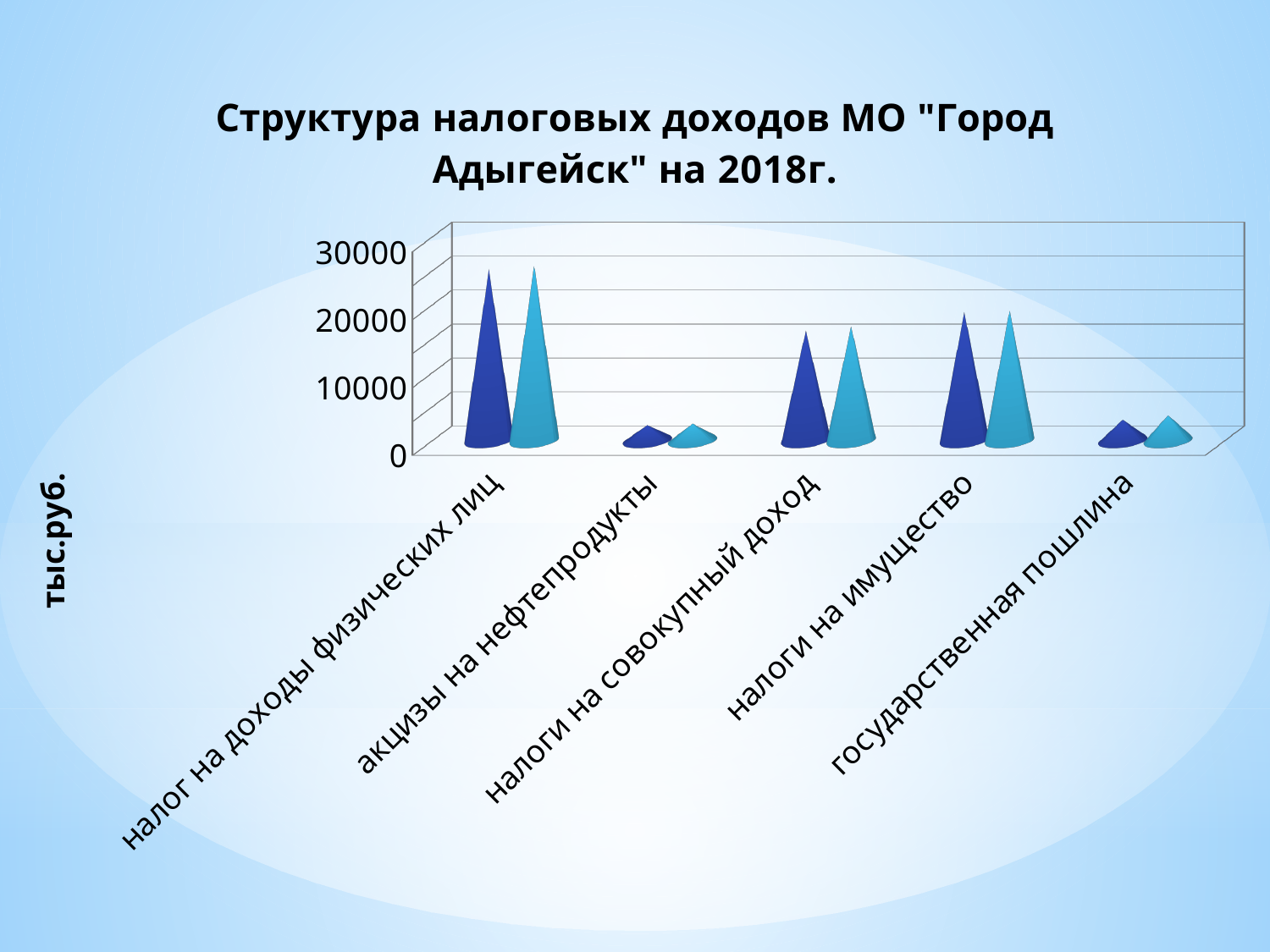
What unit is indicated for the values on the vertical axis of the chart? тыс.руб. Which category has the highest values in the chart? налог на доходы физических лиц What kind of chart is shown on the slide? bar chart Is the value for налоги на имущество greater or less than 10000? greater Which is larger, the value for налог на доходы физических лиц or the value for налоги на имущество? налог на доходы физических лиц Is the value for государственная пошлина greater or less than 10000? less Is the value for налог на доходы физических лиц greater or less than 20000? greater How many categories are shown on the x axis of the chart? 5 Which is larger, the value for акцизы на нефтепродукты or the value for налоги на совокупный доход? налоги на совокупный доход What is the title of the chart? Структура налоговых доходов МО "Город Адыгейск" на 2018г.